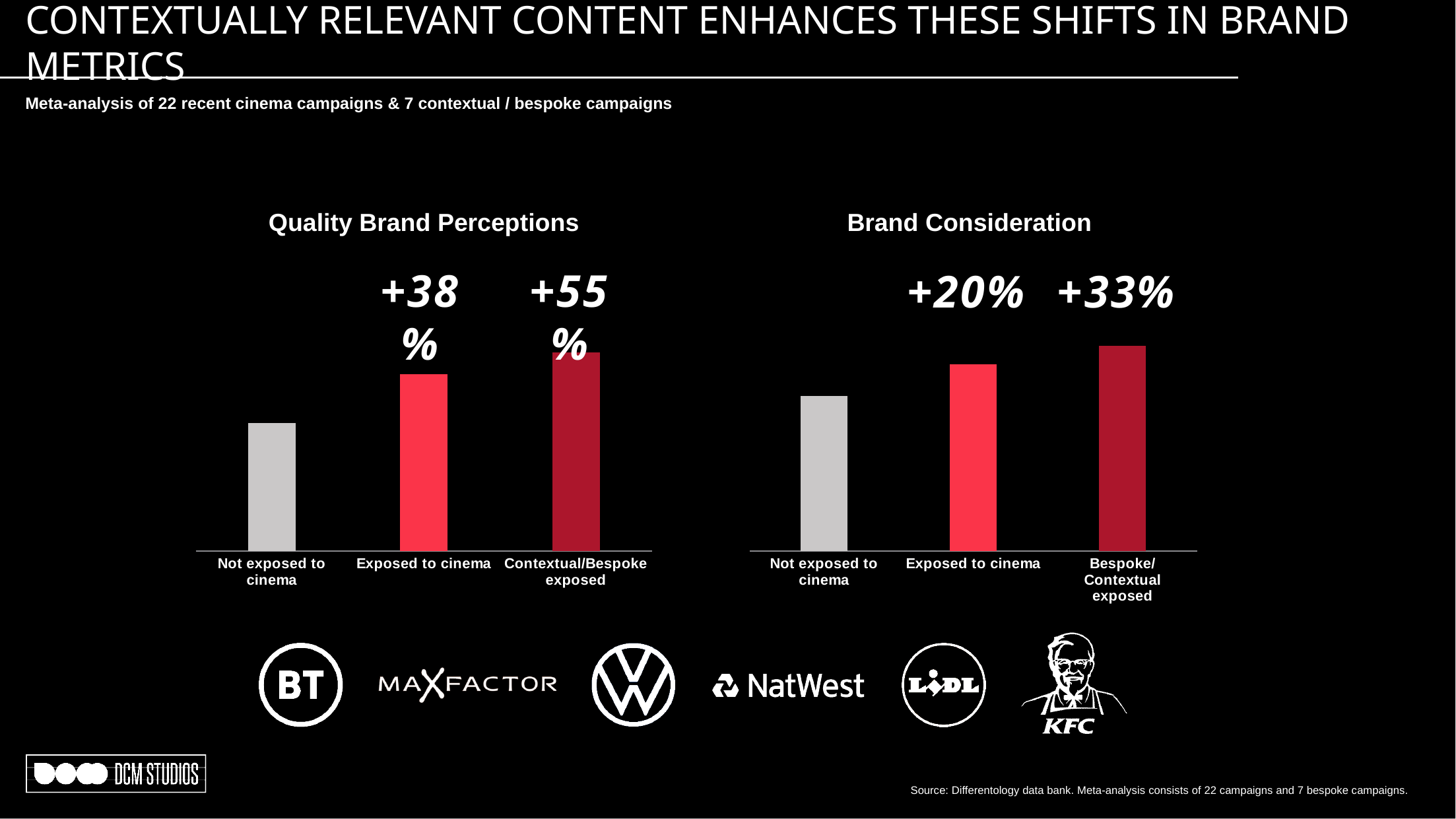
In the Brand Consideration chart, which category has the shortest bar? Not exposed to cinema In the Quality Brand Perceptions chart, which category has the tallest bar? Contextual/Bespoke exposed In the Quality Brand Perceptions chart, how much larger is the printed uplift for Contextual/Bespoke exposed than for Exposed to cinema? 17 percentage points How many bars are shown in the Quality Brand Perceptions chart? 3 In the Brand Consideration chart, what uplift is printed above the Bespoke/Contextual exposed bar? +33% What is the title of the chart on the right side of the slide? Brand Consideration In the Brand Consideration chart, what uplift is printed above the Exposed to cinema bar? +20% In the Brand Consideration chart, which bar is taller: Exposed to cinema or Bespoke/Contextual exposed? Bespoke/Contextual exposed In the Quality Brand Perceptions chart, what uplift is printed above the Contextual/Bespoke exposed bar? +55% What type of chart is the Brand Consideration chart? Bar chart In the Quality Brand Perceptions chart, do the bars rise or fall from left to right? Rise In the Quality Brand Perceptions chart, what uplift is printed above the Exposed to cinema bar? +38%